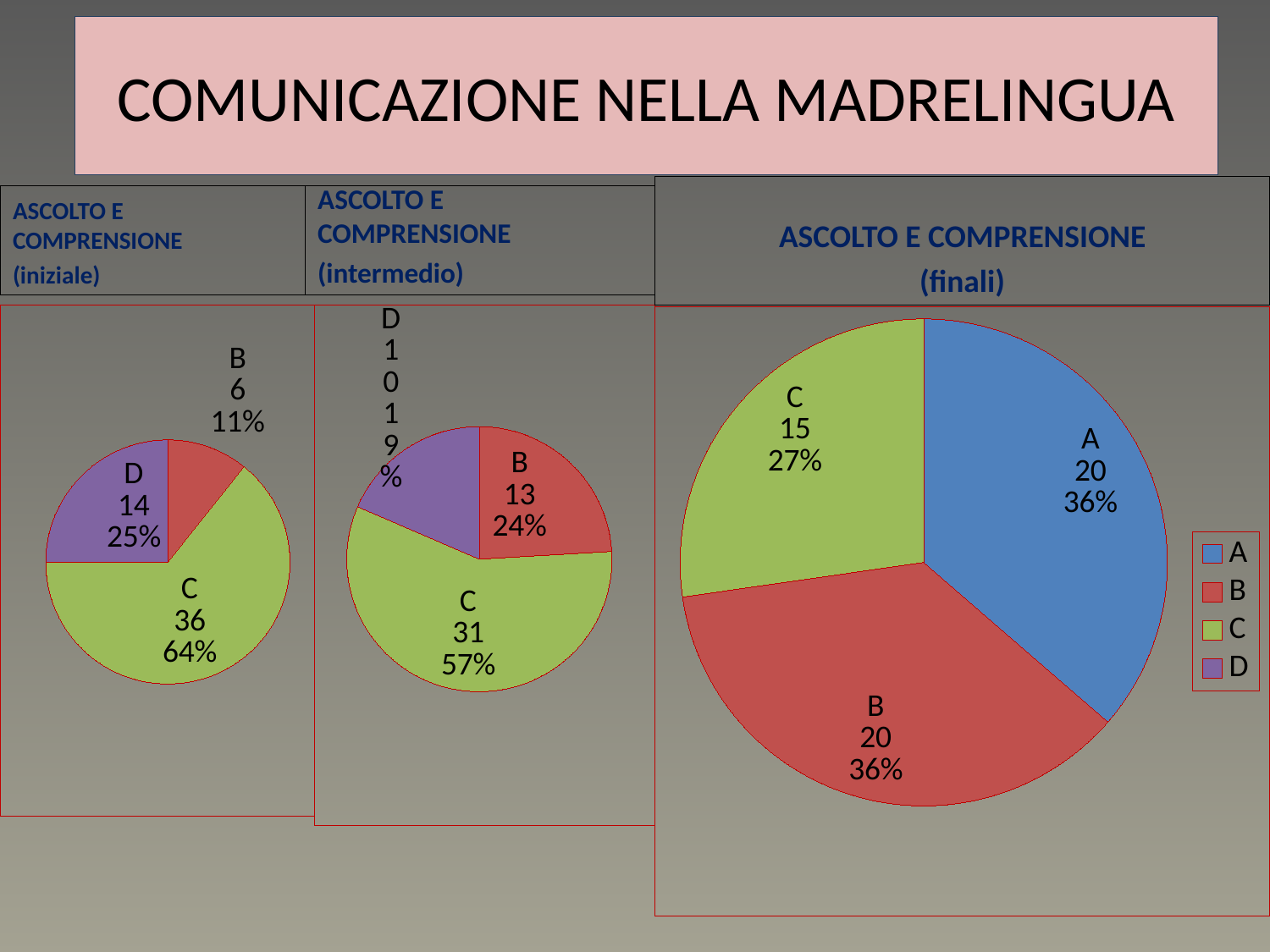
In the 'ASCOLTO E COMPRENSIONE (intermedio)' chart, what percentage share does category C have? 57% In the 'ASCOLTO E COMPRENSIONE (finali)' chart, what value is shown for category A? 20 In the 'ASCOLTO E COMPRENSIONE (iniziale)' chart, which category has the smallest slice? B In the 'ASCOLTO E COMPRENSIONE (intermedio)' chart, what value is shown for category B? 13 In the 'ASCOLTO E COMPRENSIONE (finali)' chart, how many slices does the pie have? 3 How many entries does the legend on the right of the slide list? 4 What type of chart is used for 'ASCOLTO E COMPRENSIONE (finali)'? Pie chart In the 'ASCOLTO E COMPRENSIONE (finali)' chart, what percentage share does category C have? 27% In the 'ASCOLTO E COMPRENSIONE (intermedio)' chart, what is the difference between the values for C and D? 21 In the 'ASCOLTO E COMPRENSIONE (iniziale)' chart, what percentage share does category D have? 25% In the 'ASCOLTO E COMPRENSIONE (finali)' chart, is the value for B larger or smaller than the value for C? larger In the 'ASCOLTO E COMPRENSIONE (iniziale)' chart, what value is shown for category C? 36